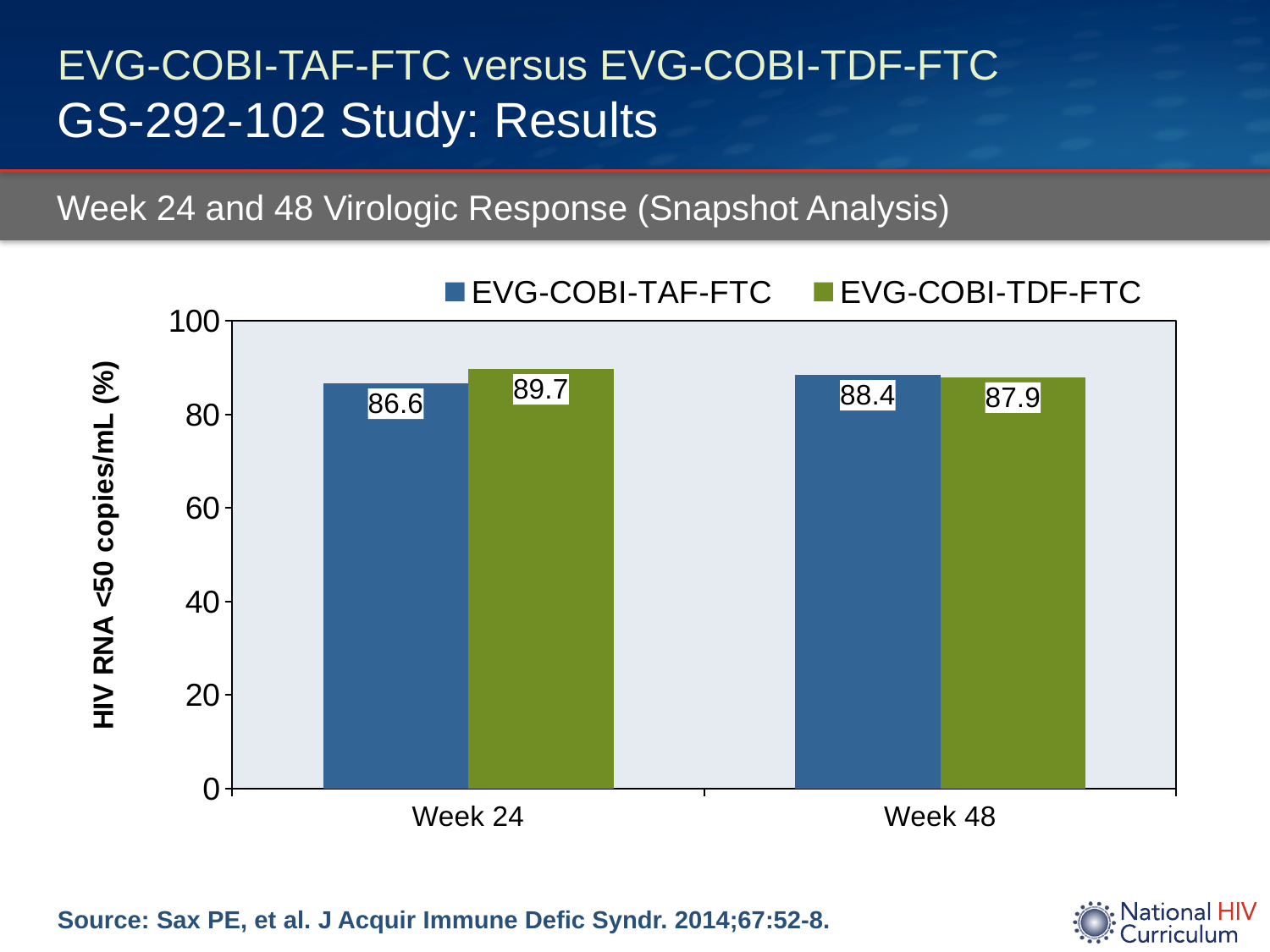
What kind of chart is shown on the slide? Bar chart How many series does the legend list? 2 At Week 24, which series has the larger value, EVG-COBI-TAF-FTC or EVG-COBI-TDF-FTC? EVG-COBI-TDF-FTC What is the difference between the EVG-COBI-TAF-FTC and EVG-COBI-TDF-FTC values at Week 48? 0.5 What is the value for EVG-COBI-TDF-FTC at Week 48? 87.9 What is the value for EVG-COBI-TDF-FTC at Week 24? 89.7 What is the difference between the EVG-COBI-TDF-FTC and EVG-COBI-TAF-FTC values at Week 24? 3.1 What is the value for EVG-COBI-TAF-FTC at Week 24? 86.6 What is the value for EVG-COBI-TAF-FTC at Week 48? 88.4 Which bar has the highest value on the chart? EVG-COBI-TDF-FTC at Week 24 What is the y-axis label of the chart? HIV RNA <50 copies/mL (%) Which bar has the lowest value on the chart? EVG-COBI-TAF-FTC at Week 24